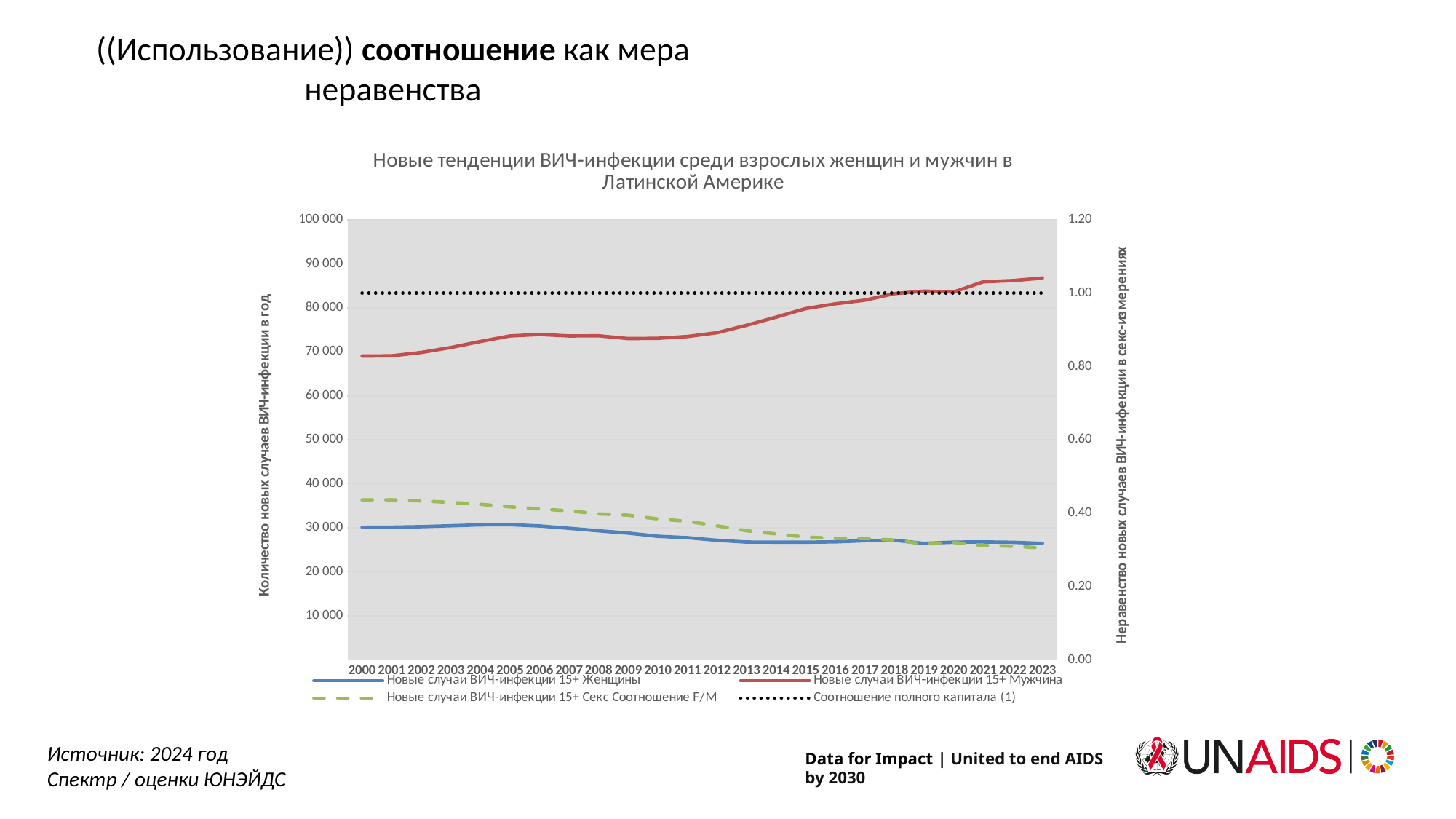
In 2023, which is larger: new HIV infections among men (Мужчина) or among women (Женщины)? Мужчина What is the title of the chart? Новые тенденции ВИЧ-инфекции среди взрослых женщин и мужчин в Латинской Америке Does the line for Новые случаи ВИЧ-инфекции 15+ Мужчина rise or fall from 2000 to 2023? rise How many series does the legend list? 4 Is the value for Новые случаи ВИЧ-инфекции 15+ Женщины in 2023 greater or less than 30 000? less How many years are shown along the x axis? 24 Does the line for Новые случаи ВИЧ-инфекции 15+ Женщины rise or fall from 2000 to 2023? fall Is the value for Новые случаи ВИЧ-инфекции 15+ Мужчина in 2023 greater or less than 80 000? greater Is the value for Новые случаи ВИЧ-инфекции 15+ Секс Соотношение F/M in 2023 greater or less than 0.40 on the right axis? less In which year is the value for Новые случаи ВИЧ-инфекции 15+ Мужчина highest? 2023 What kind of chart is shown on the slide? line chart Which series is drawn as a black dotted line? Соотношение полного капитала (1)